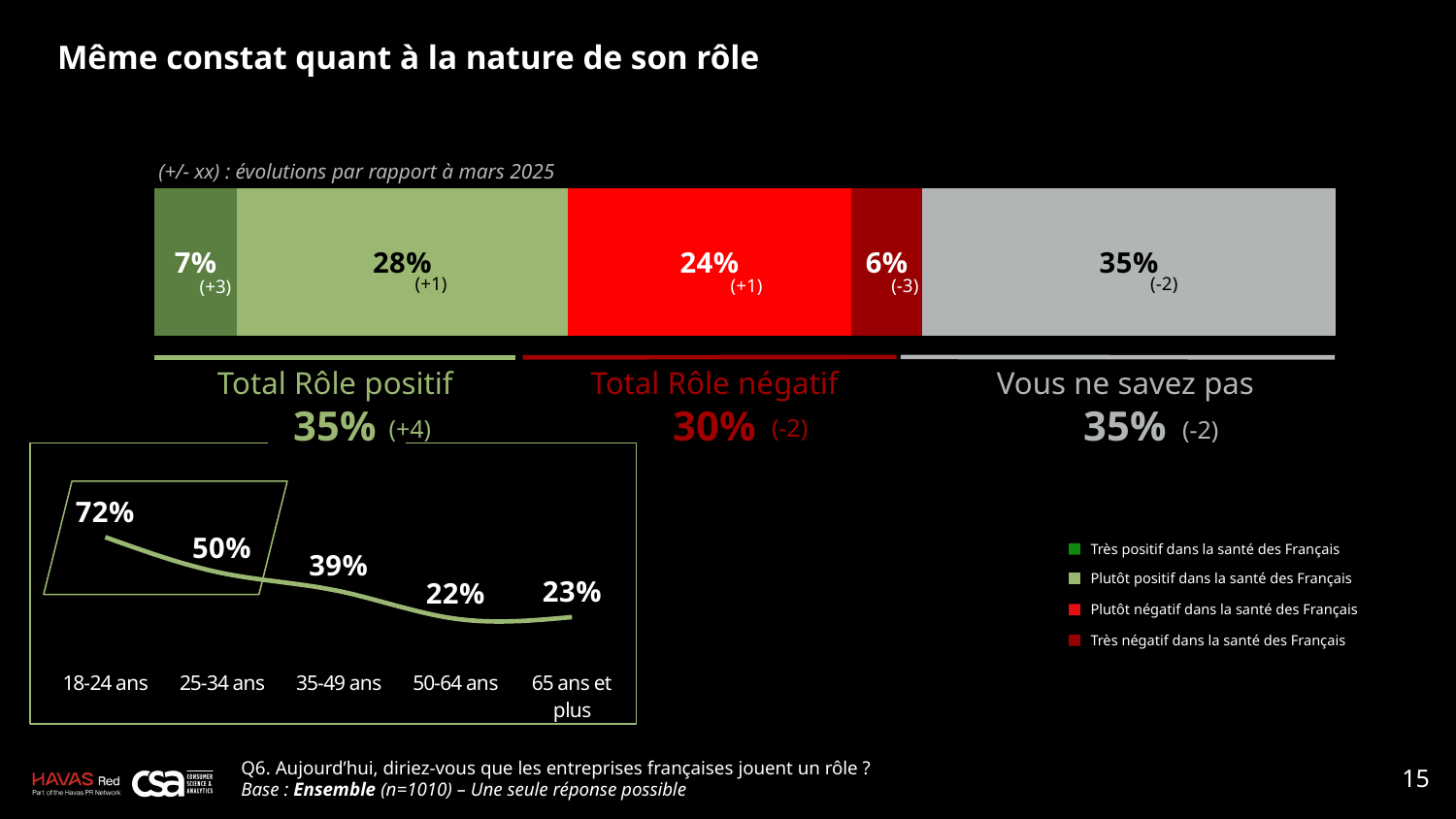
In the line chart by age group at the bottom left, how many age groups are shown? 5 In the stacked bar chart at the top, what is the value for 'Plutôt négatif dans la santé des Français'? 24% In the line chart by age group at the bottom left, what is the value for '18-24 ans'? 72% In the stacked bar chart at the top, which segment is the smallest? Très négatif dans la santé des Français (6%) In the stacked bar chart at the top, what is the value for 'Très positif dans la santé des Français'? 7% What type of chart is shown at the bottom left of the slide? Line chart In the line chart by age group at the bottom left, what is the value for '35-49 ans'? 39% In the stacked bar chart at the top, what is the total for 'Total Rôle positif'? 35% How many entries does the legend on the right list? 4 In the line chart by age group at the bottom left, which age group has the lowest value? 50-64 ans In the stacked bar chart at the top, what is the difference between the 'Plutôt positif' segment and the 'Plutôt négatif' segment? 4 points In the line chart by age group at the bottom left, what is the difference between '18-24 ans' and '25-34 ans'? 22 points